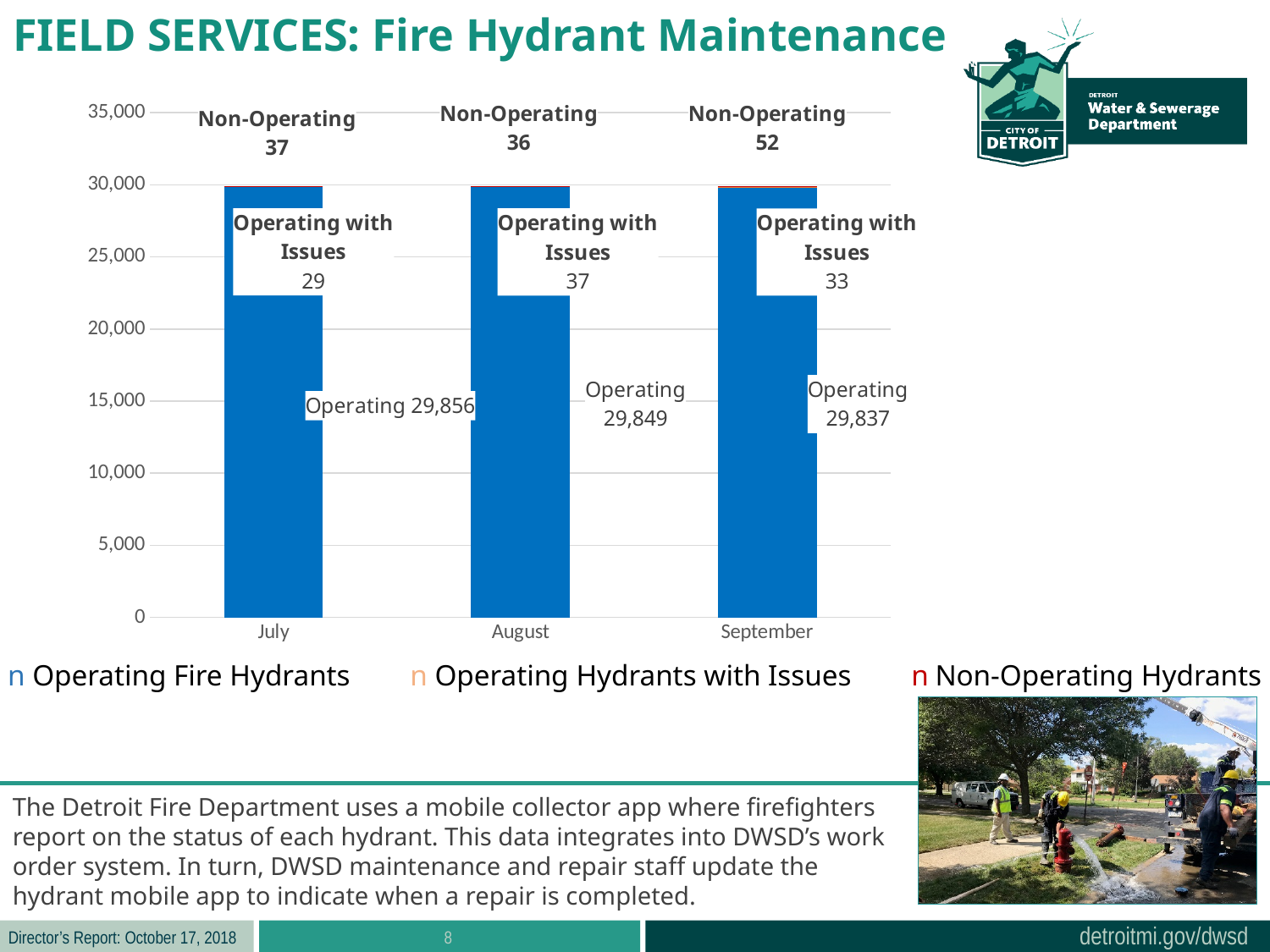
How many hydrants were Operating with Issues in August? 37 Which month has the lowest number of Operating fire hydrants? September What kind of chart is shown on the slide? Stacked bar chart What is the number of Operating fire hydrants in July? 29,856 Is the Operating value for August greater or less than 25,000? greater What is the total number of hydrants in the July bar (Operating, Operating with Issues and Non-Operating combined)? 29,922 What is the difference between the Non-Operating counts for September and August? 16 How many months are shown on the x axis? 3 Is the Operating with Issues count larger in July or in September? September What is the Non-Operating hydrant count for September? 52 Which month has the highest Non-Operating hydrant count? September How many series does the legend list? 3